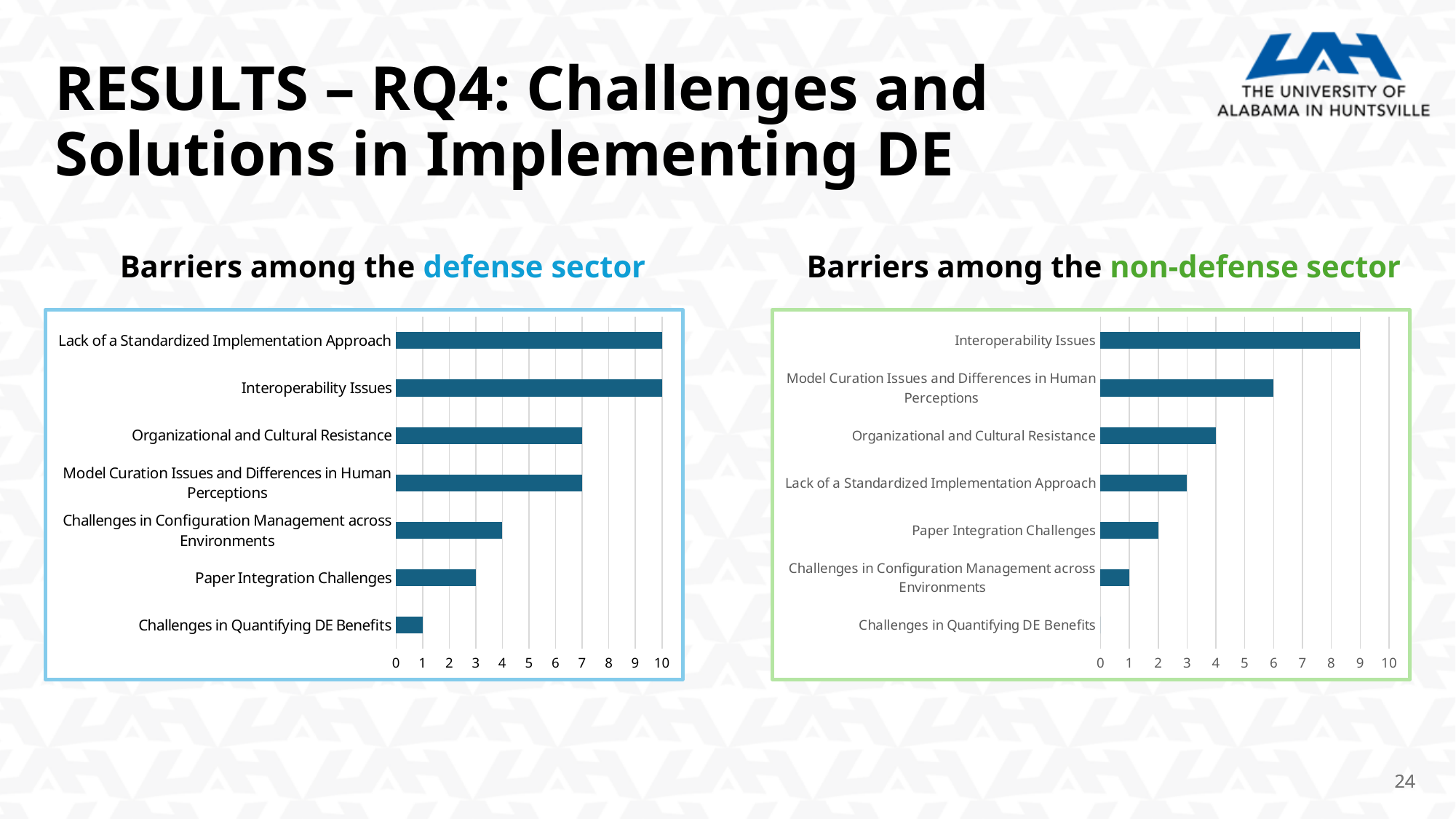
In the 'Barriers among the defense sector' chart, how many barrier categories are shown? 7 In the 'Barriers among the non-defense sector' chart, which is larger: Organizational and Cultural Resistance or Paper Integration Challenges? Organizational and Cultural Resistance In the 'Barriers among the non-defense sector' chart, is the value for Lack of a Standardized Implementation Approach greater or less than 5? less In the 'Barriers among the defense sector' chart, what is the value for Challenges in Configuration Management across Environments? 4 What is the maximum value shown on the x axis of the 'Barriers among the defense sector' chart? 10 In the 'Barriers among the defense sector' chart, what is the value for Paper Integration Challenges? 3 In the 'Barriers among the defense sector' chart, is the value for Organizational and Cultural Resistance greater or less than 5? greater In the 'Barriers among the non-defense sector' chart, what is the value for Interoperability Issues? 9 What type of chart is used for 'Barriers among the defense sector'? bar chart In the 'Barriers among the non-defense sector' chart, which barrier has the highest value? Interoperability Issues In the 'Barriers among the defense sector' chart, which barrier has the lowest value? Challenges in Quantifying DE Benefits In the 'Barriers among the non-defense sector' chart, what is the value for Model Curation Issues and Differences in Human Perceptions? 6